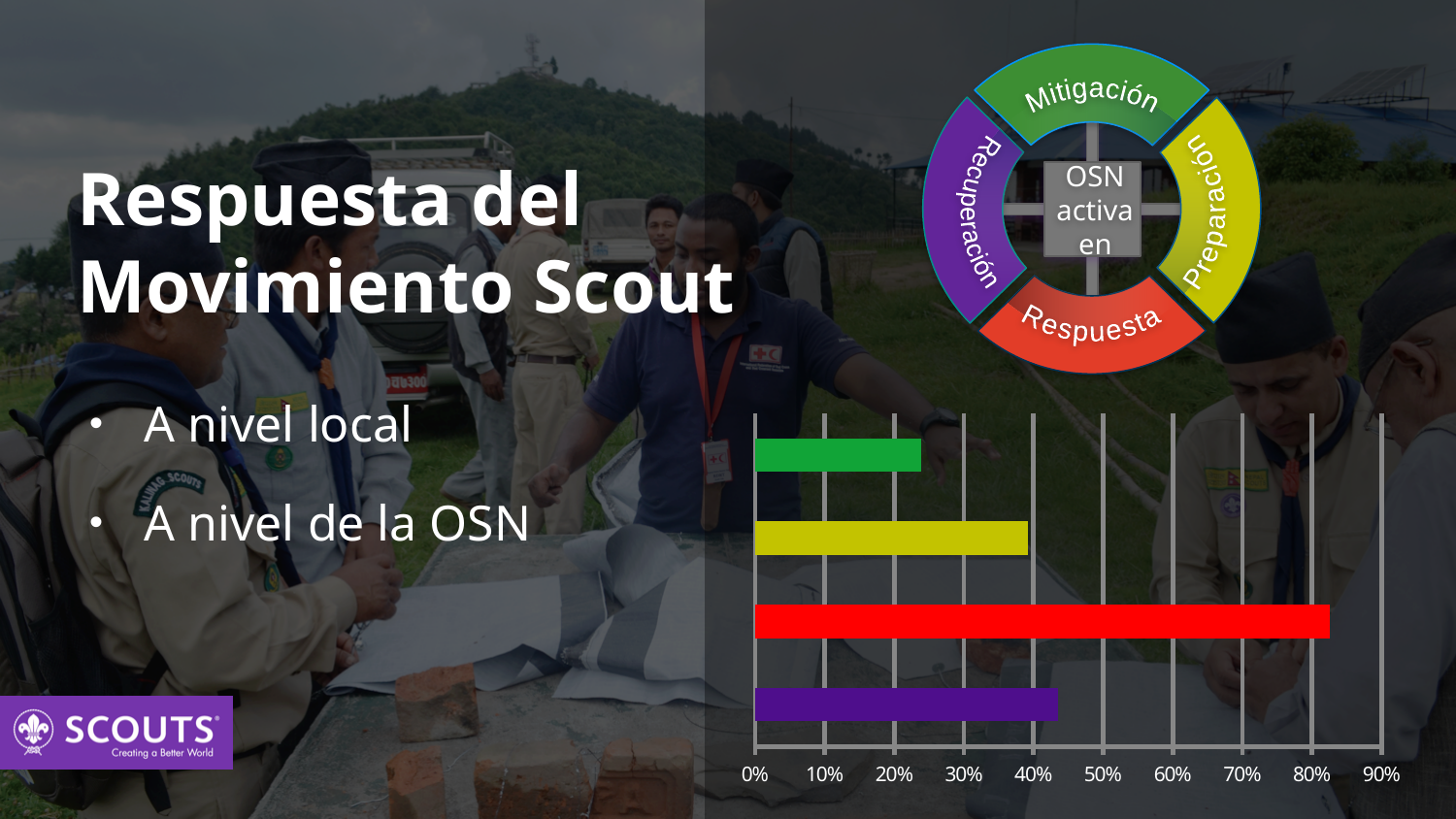
What kind of chart is shown at the bottom right of the slide? bar chart Is the value of the purple bar greater or less than 50%? less Is the value of the green bar greater or less than 30%? less How many bars does the bar chart show? 4 Is the value of the yellow bar greater or less than 30%? greater What colour is the third bar from the top in the bar chart? red Which bar in the bar chart is the shortest? the green bar Which is larger in the bar chart, the red bar or the green bar? the red bar What is the highest percentage label shown on the x axis of the bar chart? 90% Which bar in the bar chart is the longest? the red bar